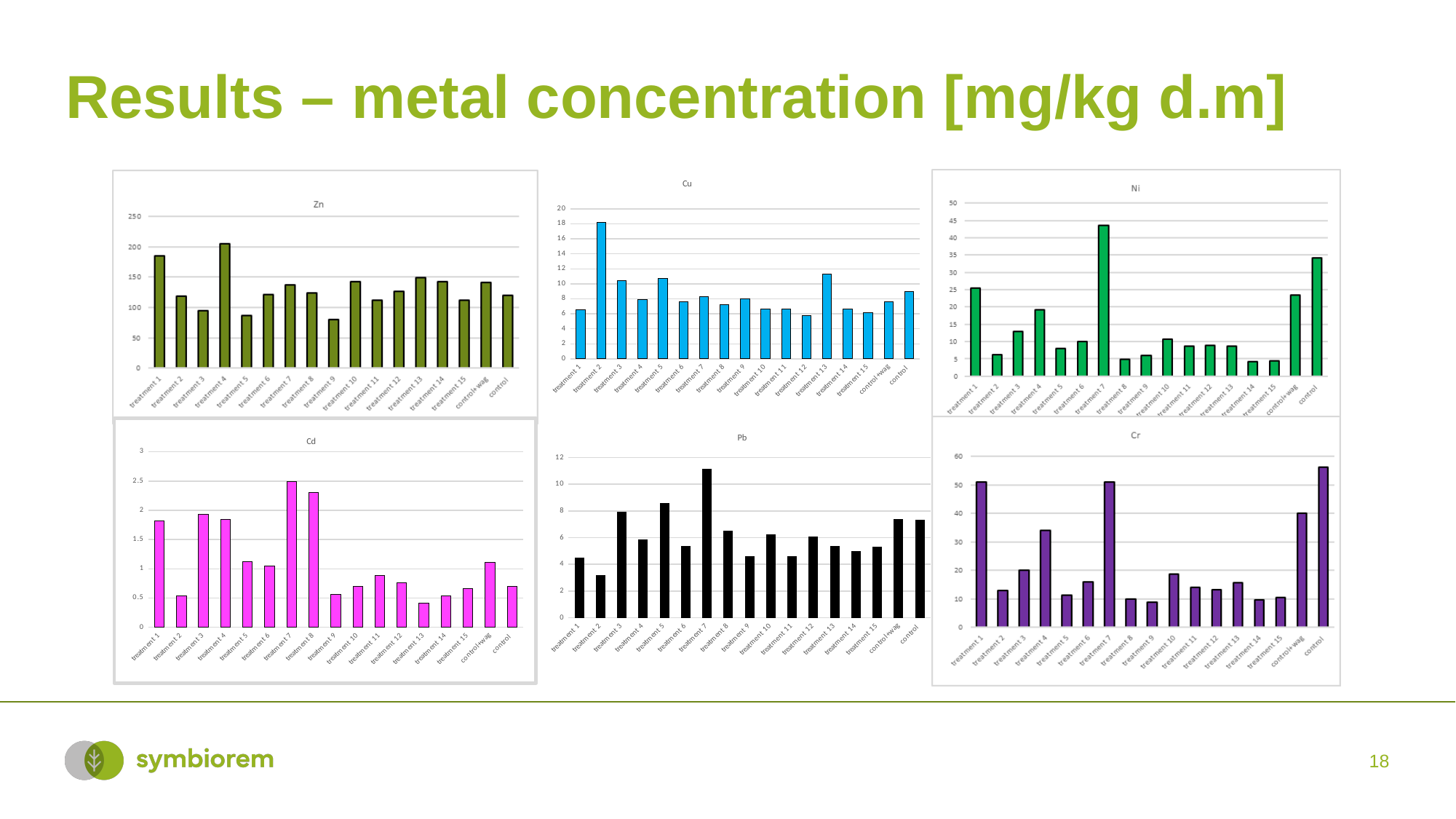
In the Cd chart, which category has the highest value? treatment 7 In the Zn chart, which category has the highest value? treatment 4 How many categories are shown on the x axis of the Zn chart? 17 In the Cu chart, which category has the highest value? treatment 2 In the Zn chart, which category has the lowest value? treatment 9 In the Ni chart, which is larger, the value for control or the value for control+wag? control In the Cd chart, which category has the lowest value? treatment 13 In the Zn chart, is the value for treatment 1 greater or less than 150? greater In the Cu chart, is the value for treatment 13 greater or less than 10? greater